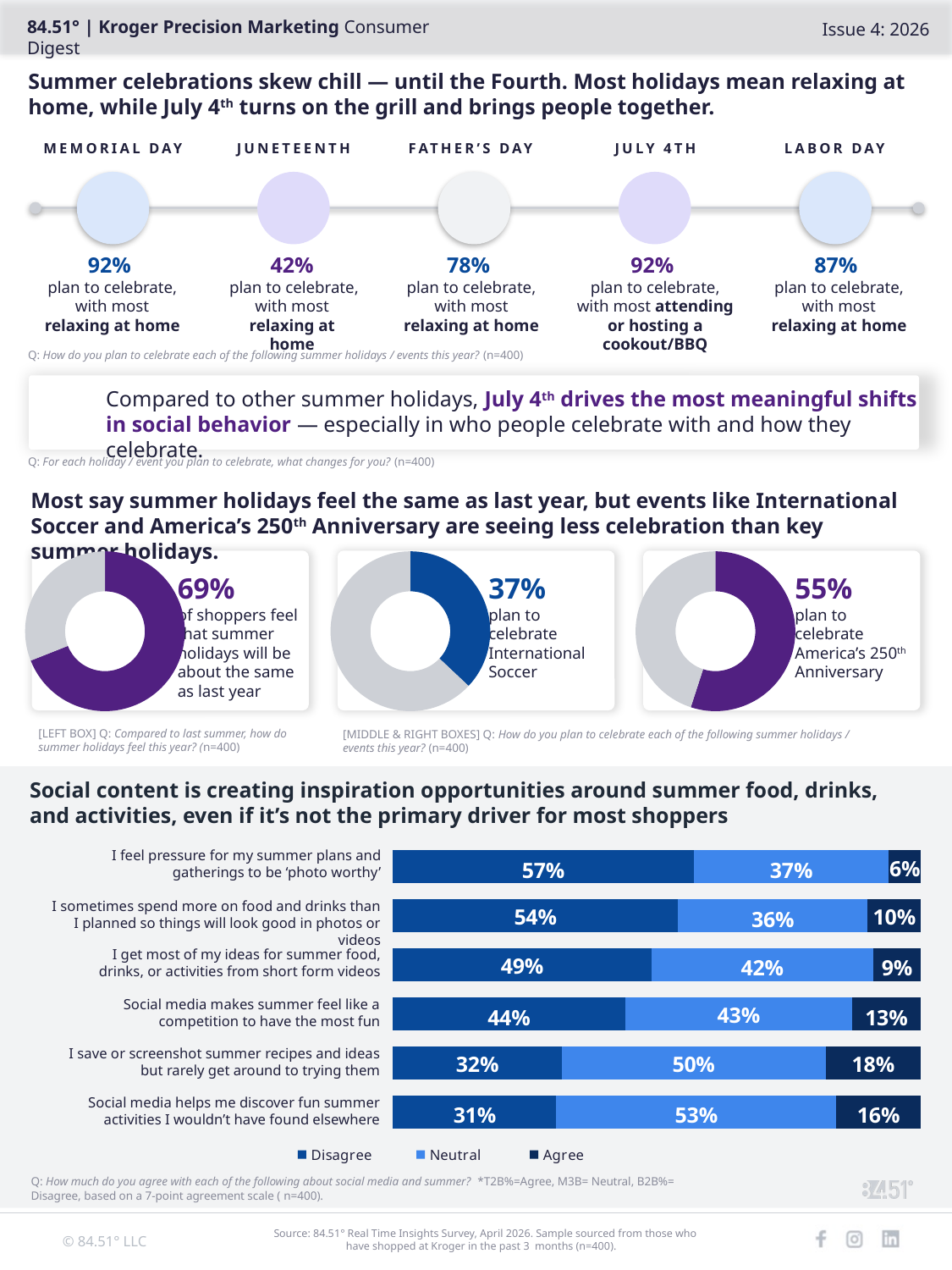
In the stacked bar chart about social media and summer, which has the larger Disagree share: 'I sometimes spend more on food and drinks than I planned...' or 'I get most of my ideas for summer food, drinks, or activities from short form videos'? I sometimes spend more on food and drinks than I planned so things will look good in photos or videos What kind of chart is used to show agreement with the social media and summer statements? Stacked bar chart In the stacked bar chart about social media and summer, which statement has the lowest Agree percentage? I feel pressure for my summer plans and gatherings to be 'photo worthy' Comparing the middle and right donut charts, which has the larger share: those planning to celebrate International Soccer or those planning to celebrate America's 250th Anniversary? America's 250th Anniversary In the stacked bar chart about social media and summer, which statement has the highest Agree percentage? I save or screenshot summer recipes and ideas but rarely get around to trying them In the stacked bar chart about social media and summer, what percentage agree with 'I save or screenshot summer recipes and ideas but rarely get around to trying them'? 18% In the stacked bar chart about social media and summer, what percentage disagree with 'I feel pressure for my summer plans and gatherings to be photo worthy'? 57% In the stacked bar chart about social media and summer, how much higher is the Neutral share for 'Social media helps me discover fun summer activities I wouldn't have found elsewhere' than for 'I feel pressure for my summer plans and gatherings to be photo worthy'? 16 percentage points In the middle donut chart, what percentage plan to celebrate International Soccer? 37% How many series does the legend of the stacked bar chart about social media and summer list? 3 How many statements are shown in the stacked bar chart about social media and summer? 6 In the stacked bar chart about social media and summer, what is the total of the three segments for 'I feel pressure for my summer plans and gatherings to be photo worthy'? 100%